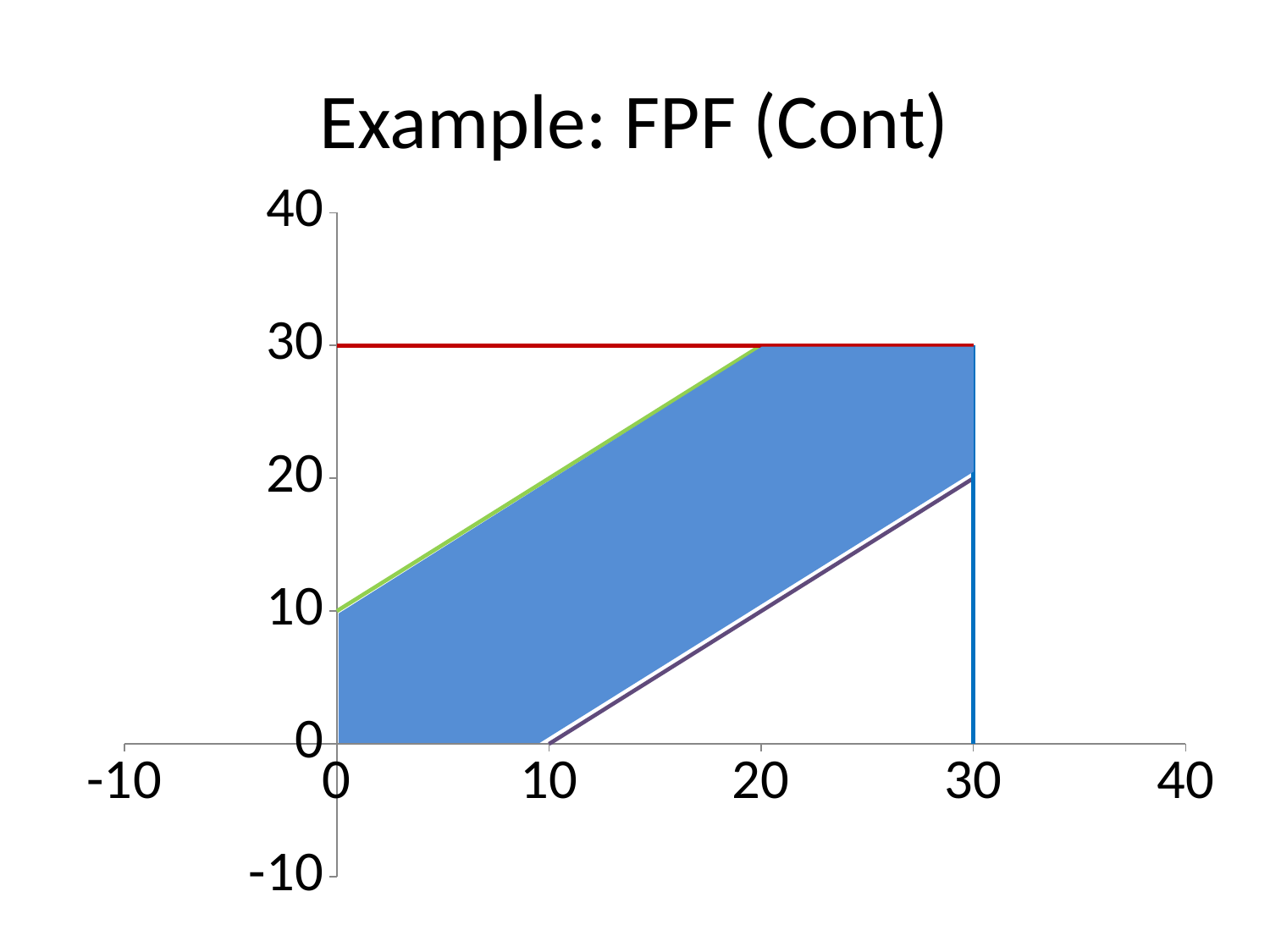
Is the y value of the green line at x = 10 greater or less than 10? greater At what x value does the purple line cross the x axis (y = 0)? 10 What kind of chart is shown on the slide? line chart with a shaded area Does the green line rise or fall as x increases? rise What is the title of the chart? Example: FPF (Cont) At what x value does the green line reach the red line at y = 30? 20 What is the highest value shown on the y axis? 40 At what y value does the red horizontal line sit? 30 Which is larger: the y value of the green line at x = 0 or the y value of the purple line at x = 30? the purple line at x = 30 What is the y value of the purple line at x = 30? 20 At what y value does the green line meet the y axis (x = 0)? 10 At what x value is the vertical blue line drawn? 30